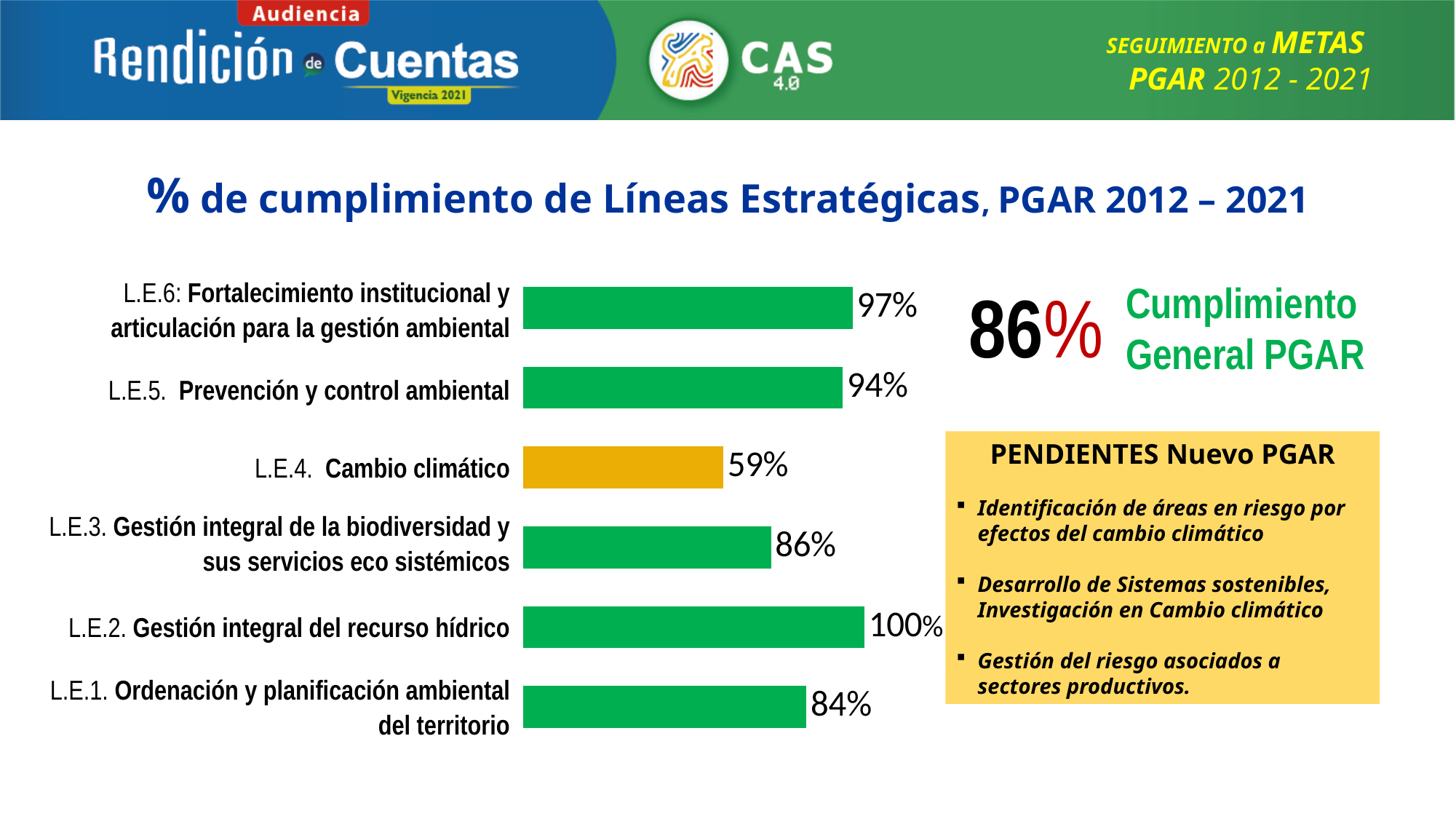
Which is larger, the value for L.E.6 or the value for L.E.5? L.E.6 How many líneas estratégicas are shown in the chart? 6 Which línea estratégica has the highest percentage of cumplimiento? L.E.2 Gestión integral del recurso hídrico What kind of chart is shown on the slide? Bar chart Which bar in the chart is coloured differently (orange) from the others? L.E.4 Cambio climático What is the value for L.E.1 Ordenación y planificación ambiental del territorio? 84% Which línea estratégica has the lowest percentage of cumplimiento? L.E.4 Cambio climático What is the value for L.E.6 Fortalecimiento institucional y articulación para la gestión ambiental? 97% What is the value for L.E.2 Gestión integral del recurso hídrico? 100% What is the difference between the values for L.E.5 Prevención y control ambiental and L.E.3 Gestión integral de la biodiversidad y sus servicios eco sistémicos? 8% What is the value for L.E.4 Cambio climático? 59% What is the title of the chart? % de cumplimiento de Líneas Estratégicas, PGAR 2012 – 2021